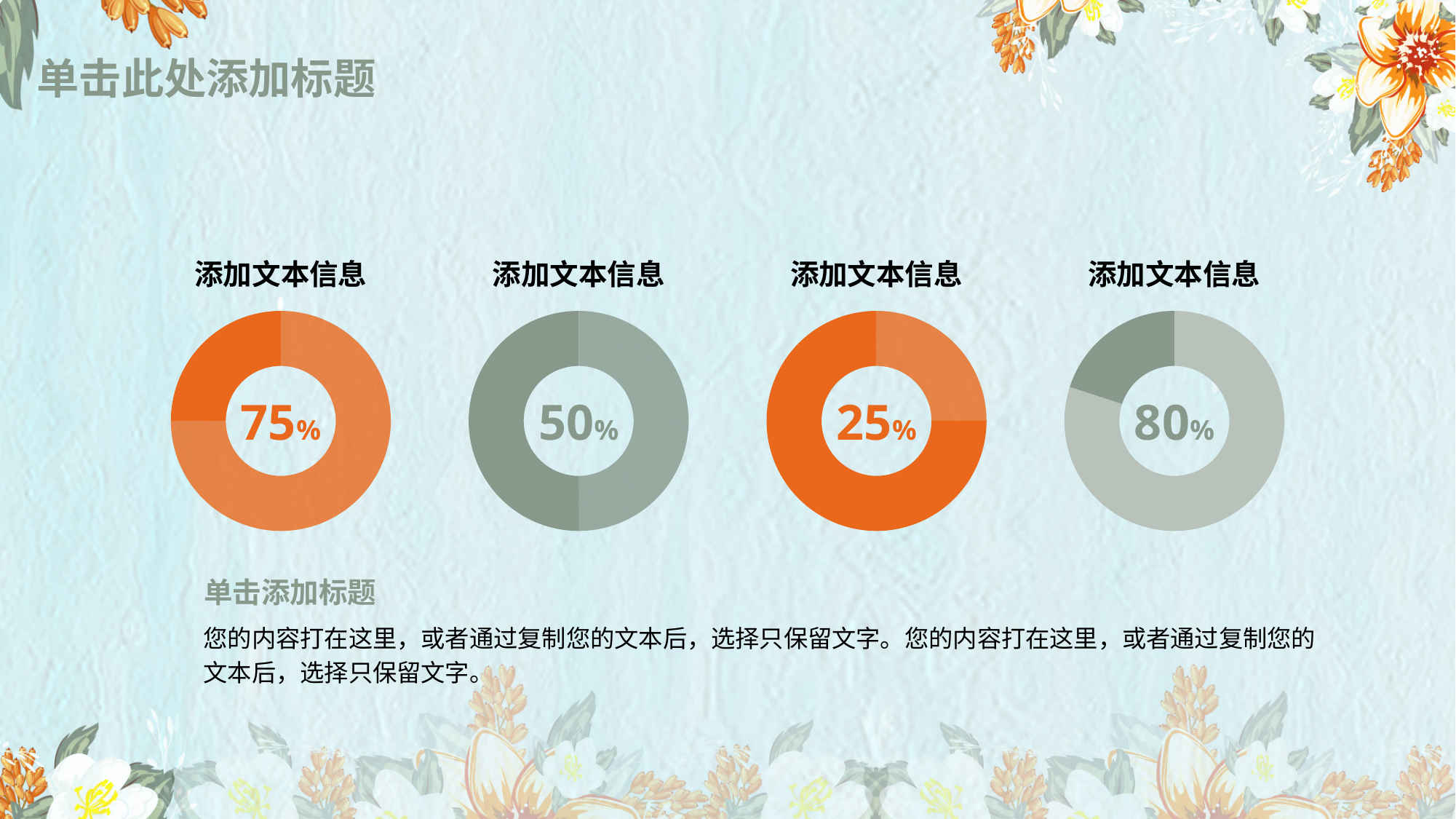
What value is shown in the center of the second donut chart from the left? 50% What value is shown in the center of the rightmost donut chart? 80% What is the difference between the values in the rightmost and second-from-left donut charts? 30% What colour is the filled portion of the third donut chart from the left? Orange What type of chart is used to display the percentages on this slide? Donut (pie) chart What value is shown in the center of the leftmost donut chart? 75% Which is larger: the value in the leftmost donut chart or the value in the rightmost donut chart? The rightmost chart (80%) Which of the four donut charts shows the lowest percentage? The third chart from the left (25%) Which of the four donut charts shows the highest percentage? The rightmost chart (80%) What value is shown in the center of the third donut chart from the left? 25% What is the difference between the percentage in the leftmost donut chart and the percentage in the third donut chart? 50% How many donut charts are shown on the slide? 4